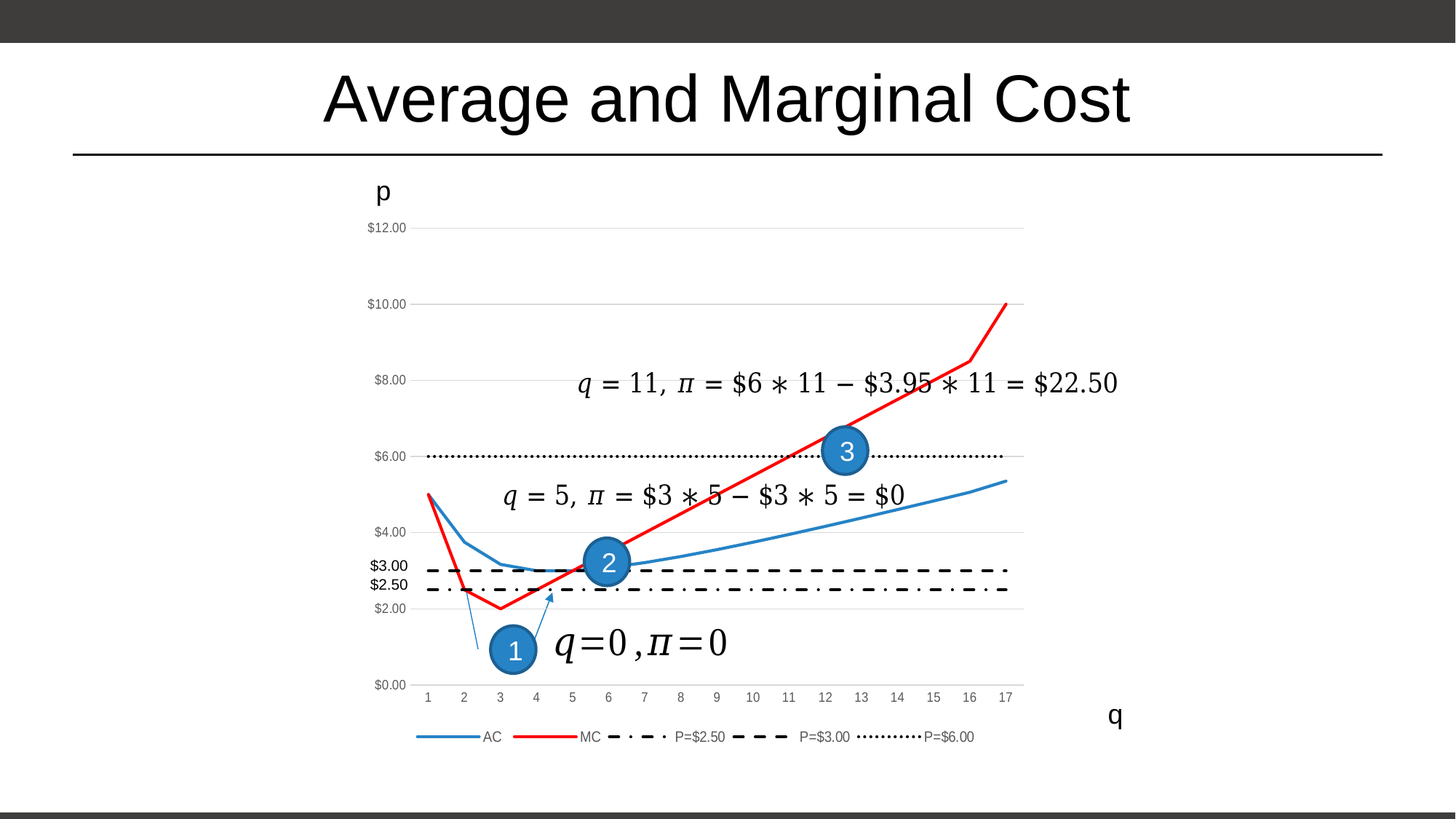
Does the MC curve rise or fall from q = 3 to q = 17? rise Is the value of MC at q = 16 greater or less than $8.00? greater At q = 17, which is larger, MC or AC? MC At what price level is the dotted horizontal line P=$6.00 drawn? $6.00 At which quantity does the MC curve reach its lowest value? 3 What colour is the MC line? red What kind of chart is shown on the slide? line chart How many series does the legend list? 5 What is the value of MC at q = 3? $2.00 How many quantity values are marked along the x axis? 17 What is the value of MC at q = 17? $10.00 Is the value of AC at q = 17 greater or less than $6.00? less